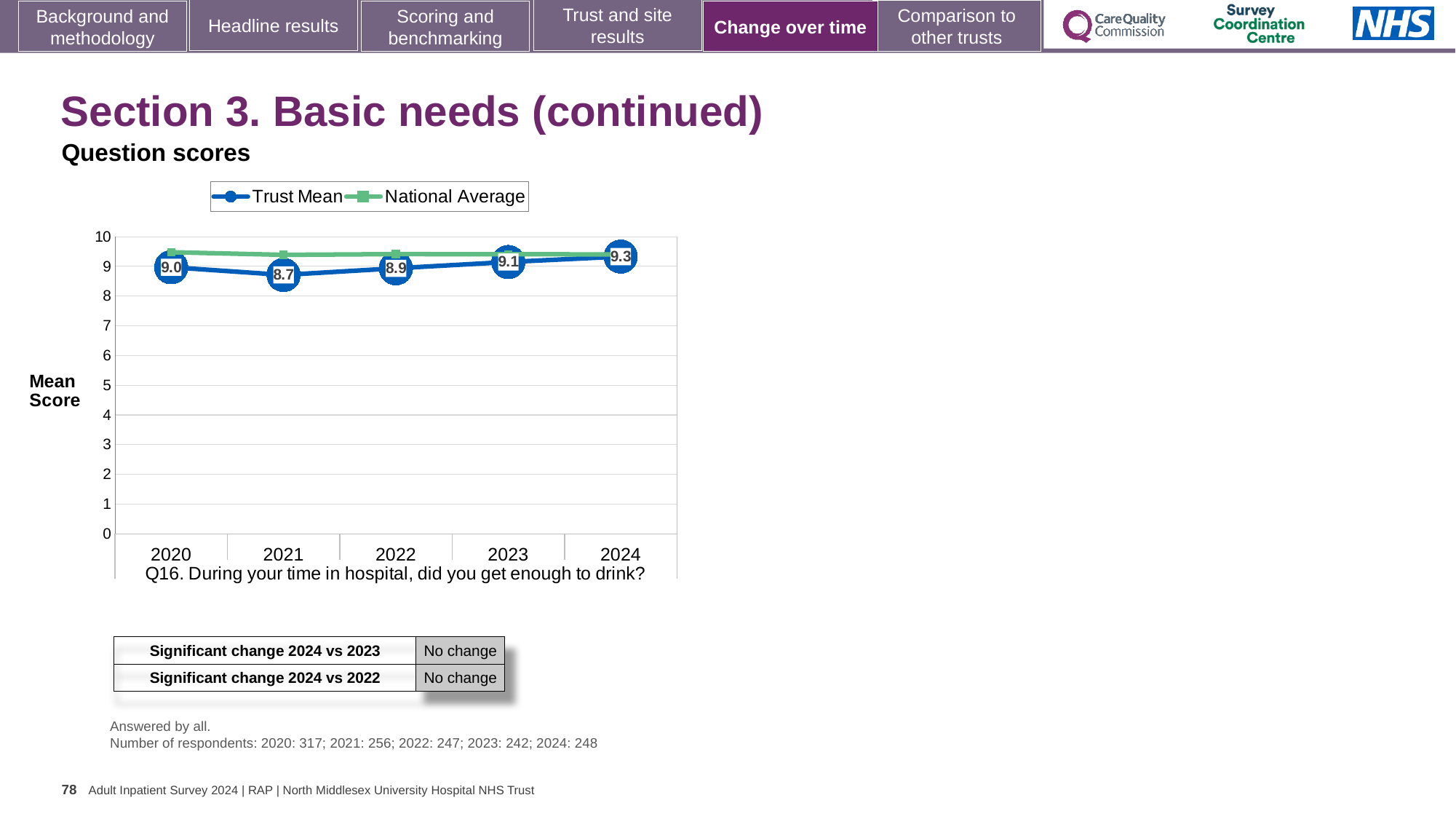
What is the Trust Mean score for 2021? 8.7 In which year is the Trust Mean score highest? 2024 Which year has the larger Trust Mean score, 2020 or 2022? 2020 What is the Trust Mean score for 2024? 9.3 Is the National Average value for 2020 greater or less than 9? greater How many series does the chart legend list? 2 What is the difference between the Trust Mean scores for 2024 and 2021? 0.6 In which year is the Trust Mean score lowest? 2021 How many years are shown on the x axis of the chart? 5 Does the Trust Mean score rise or fall from 2021 to 2024? Rise What is the Trust Mean score for 2020? 9.0 What kind of chart is shown on the slide? Line chart